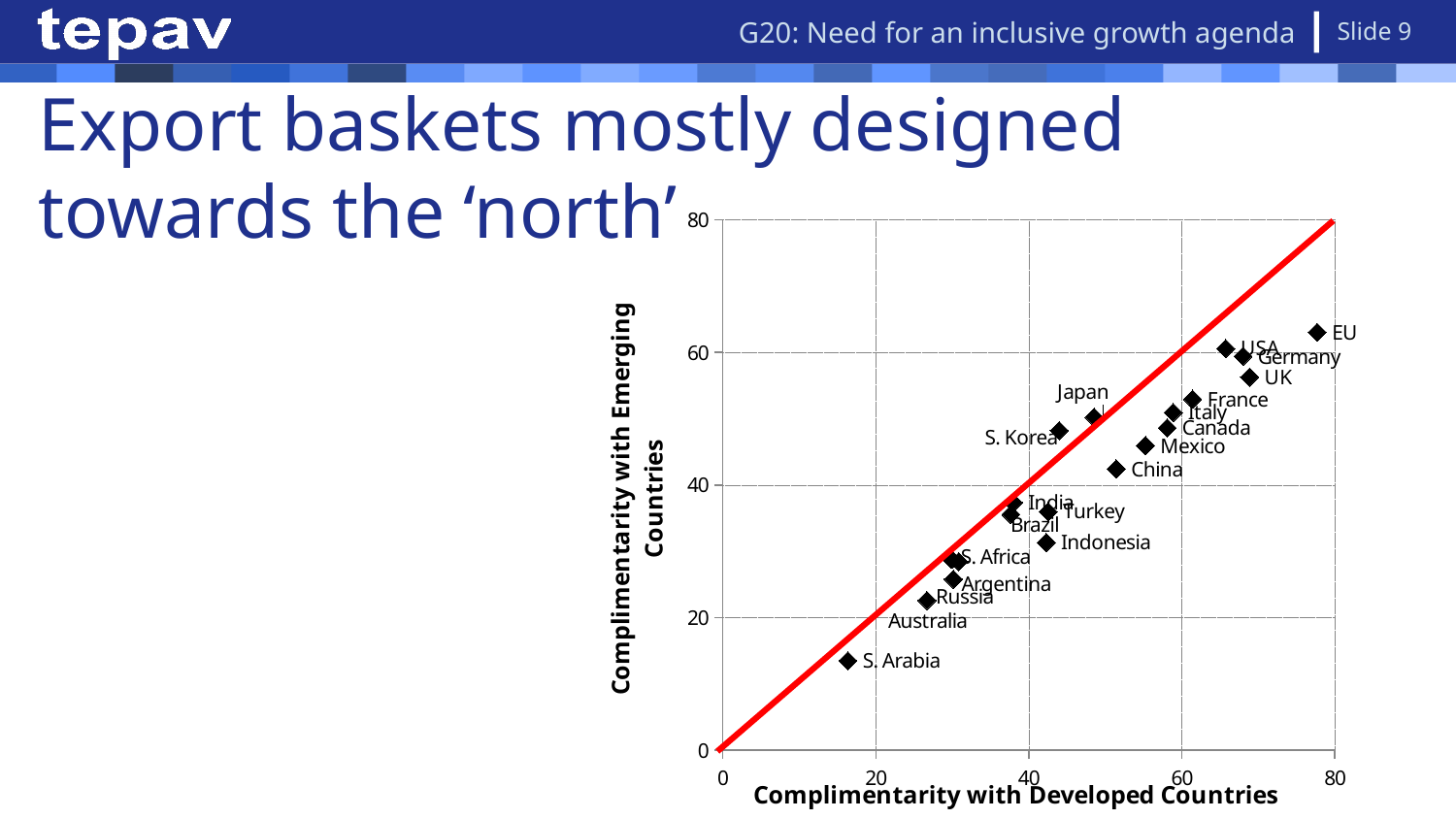
How many labelled country points are plotted on the chart? 20 Is the 'Complimentarity with Developed Countries' value for Japan greater or less than 40? greater Which country has the lowest value on the 'Complimentarity with Emerging Countries' axis? S. Arabia Which country has the highest value on the 'Complimentarity with Emerging Countries' axis? EU Is the 'Complimentarity with Emerging Countries' value for EU greater or less than 60? greater Which has a higher 'Complimentarity with Developed Countries' value, USA or Mexico? USA What kind of chart is shown on the slide? scatter chart What is the title of the horizontal axis of the chart? Complimentarity with Developed Countries Is the 'Complimentarity with Emerging Countries' value for S. Arabia greater or less than 20? less Which has a higher 'Complimentarity with Emerging Countries' value, Japan or China? Japan Which country has the lowest value on the 'Complimentarity with Developed Countries' axis? S. Arabia